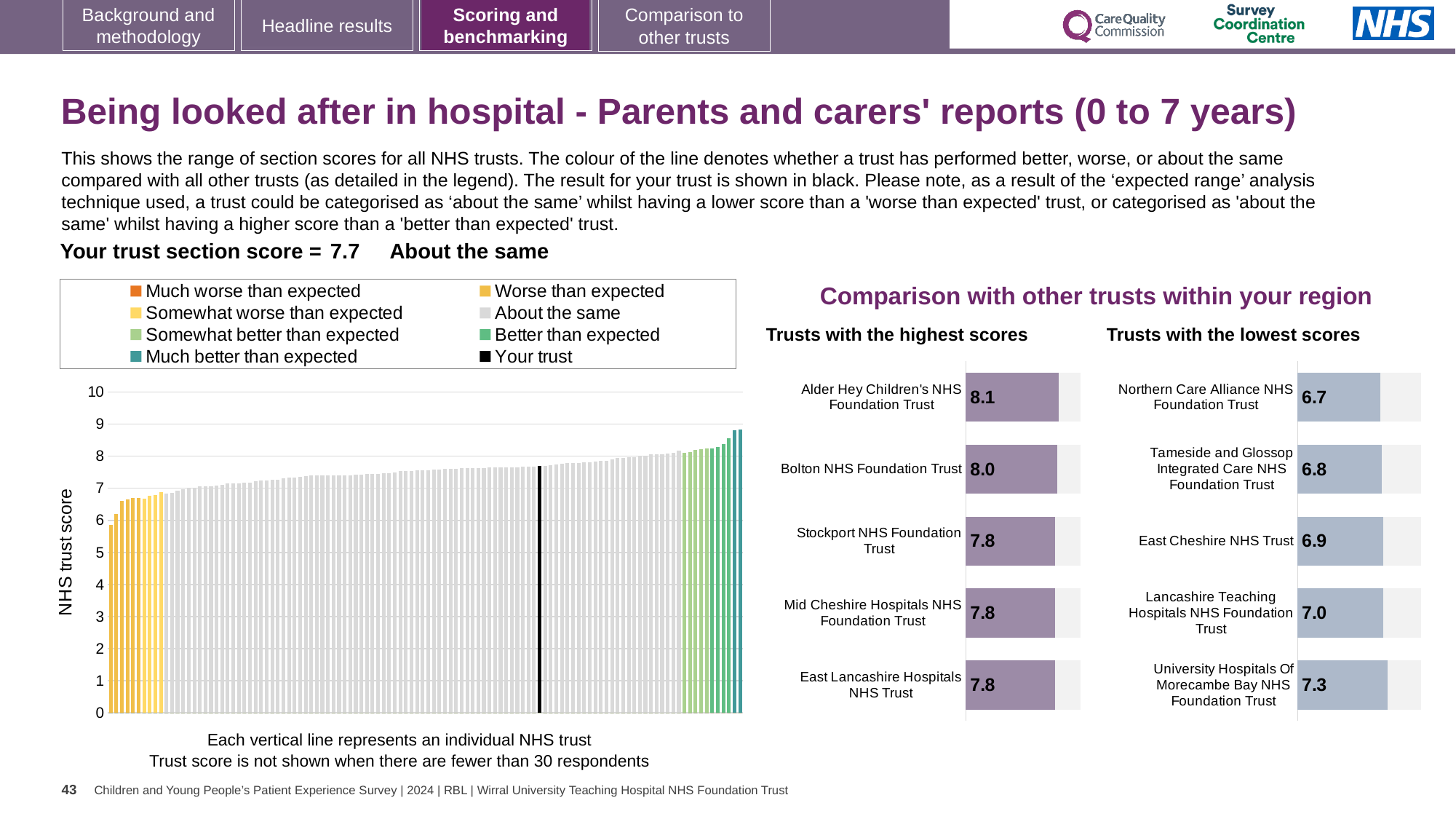
In the 'Trusts with the highest scores' chart, what is the difference between Alder Hey Children's NHS Foundation Trust and Stockport NHS Foundation Trust? 0.3 In the 'Trusts with the lowest scores' chart, which trust has the lowest score? Northern Care Alliance NHS Foundation Trust In the main chart on the left, do the trust scores rise or fall from left to right? Rise In the 'Trusts with the highest scores' chart, how many trusts are shown? 5 In the main chart on the left, is the value for the lowest bar greater or less than 7? less In the main chart on the left, is the value for the black bar (Your trust) greater or less than 7? greater In the 'Trusts with the highest scores' chart, what is the value for Alder Hey Children's NHS Foundation Trust? 8.1 How many entries does the legend above the main chart on the left list? 8 In the 'Trusts with the lowest scores' chart, which is larger: the value for University Hospitals Of Morecambe Bay NHS Foundation Trust or Lancashire Teaching Hospitals NHS Foundation Trust? University Hospitals Of Morecambe Bay NHS Foundation Trust What kind of chart is the main chart on the left showing NHS trust scores? Bar chart In the 'Trusts with the lowest scores' chart, what is the value for East Cheshire NHS Trust? 6.9 In the 'Trusts with the highest scores' chart, which trust has the highest score? Alder Hey Children's NHS Foundation Trust